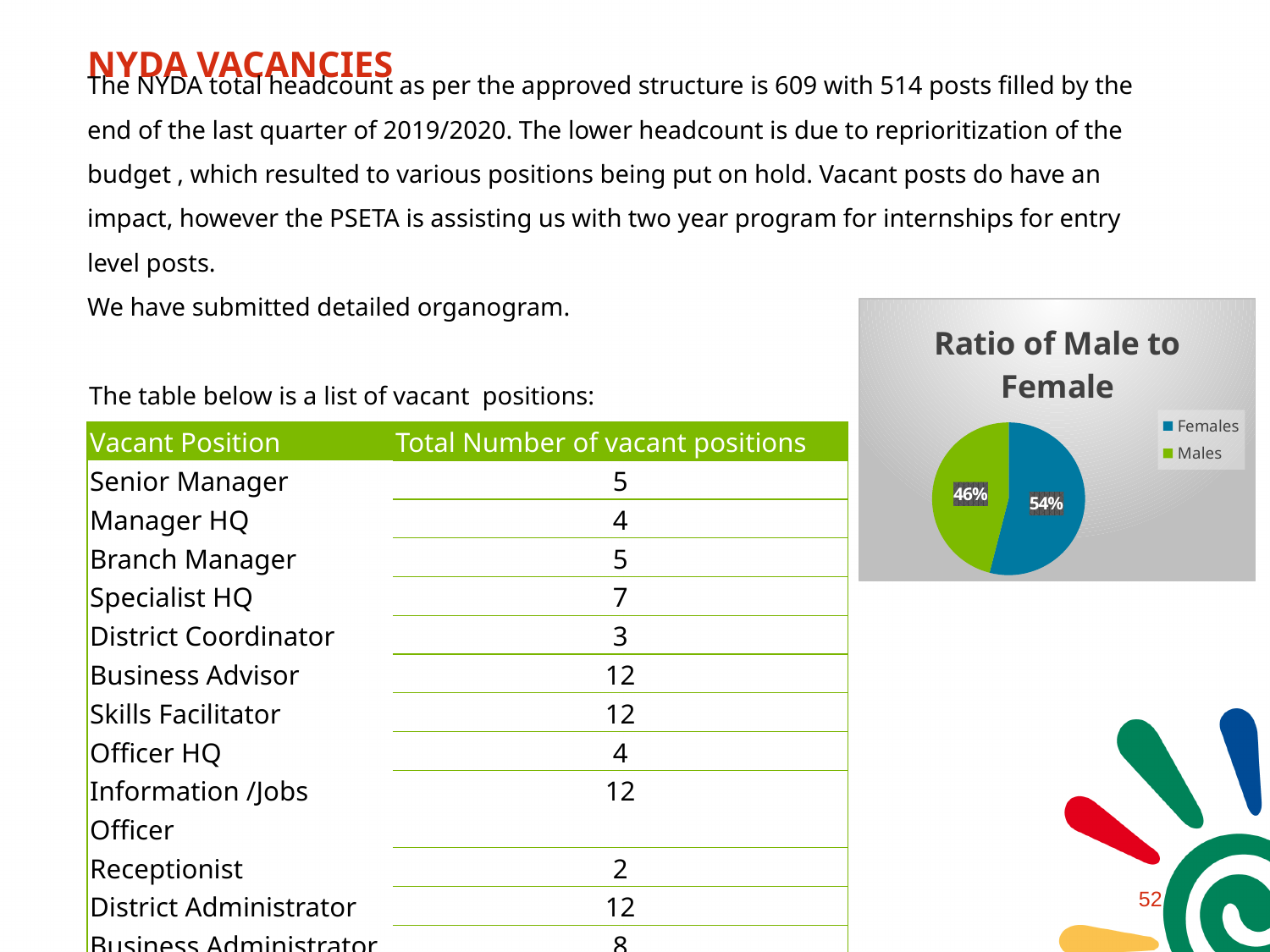
Which slice of the pie chart is the smallest? Males What share of the pie chart is Females? 54% How many slices does the pie chart have? 2 What share of the pie chart is Males? 46% What is the title of the pie chart on the slide? Ratio of Male to Female How many series does the legend of the pie chart list? 2 What is the difference in percentage points between the Females and Males slices of the pie chart? 8 Which slice of the pie chart is the largest? Females Which is larger in the pie chart, Females or Males? Females What kind of chart is shown on the slide? pie chart Which colour represents Males in the pie chart? green